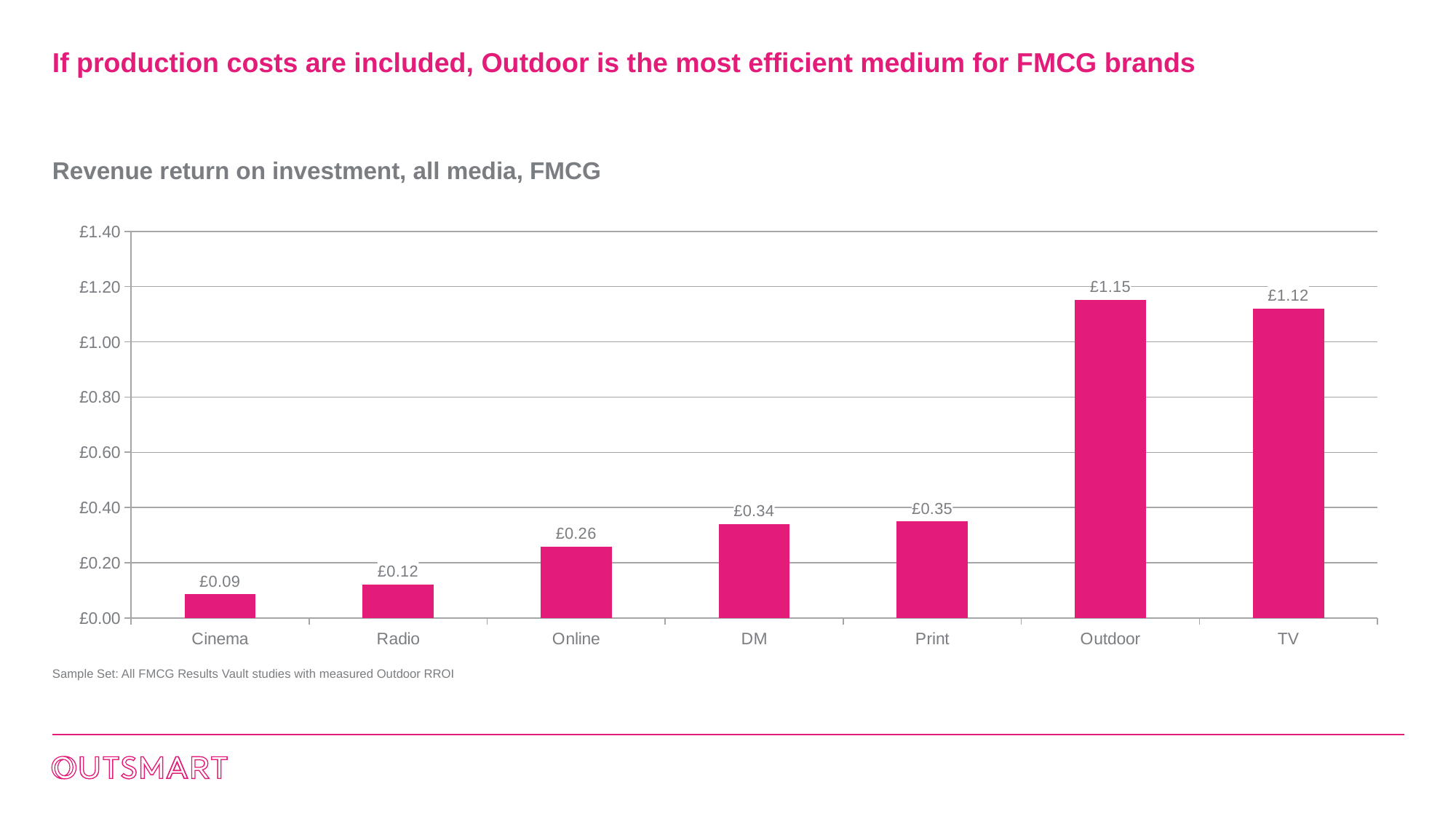
Is the value for TV greater or less than £1.00? greater Which medium has the highest revenue return on investment? Outdoor What is the revenue return on investment for Outdoor? £1.15 What is the difference between the values for Print and Radio? £0.23 How many media categories are shown on the chart? 7 What is the value shown for Online? £0.26 What is the revenue return on investment for Cinema? £0.09 Which medium has the lowest revenue return on investment? Cinema Which has a higher value, DM or Online? DM What is the title of the chart? Revenue return on investment, all media, FMCG What is the difference between the values for Outdoor and TV? £0.03 What kind of chart is shown on the slide? Bar chart